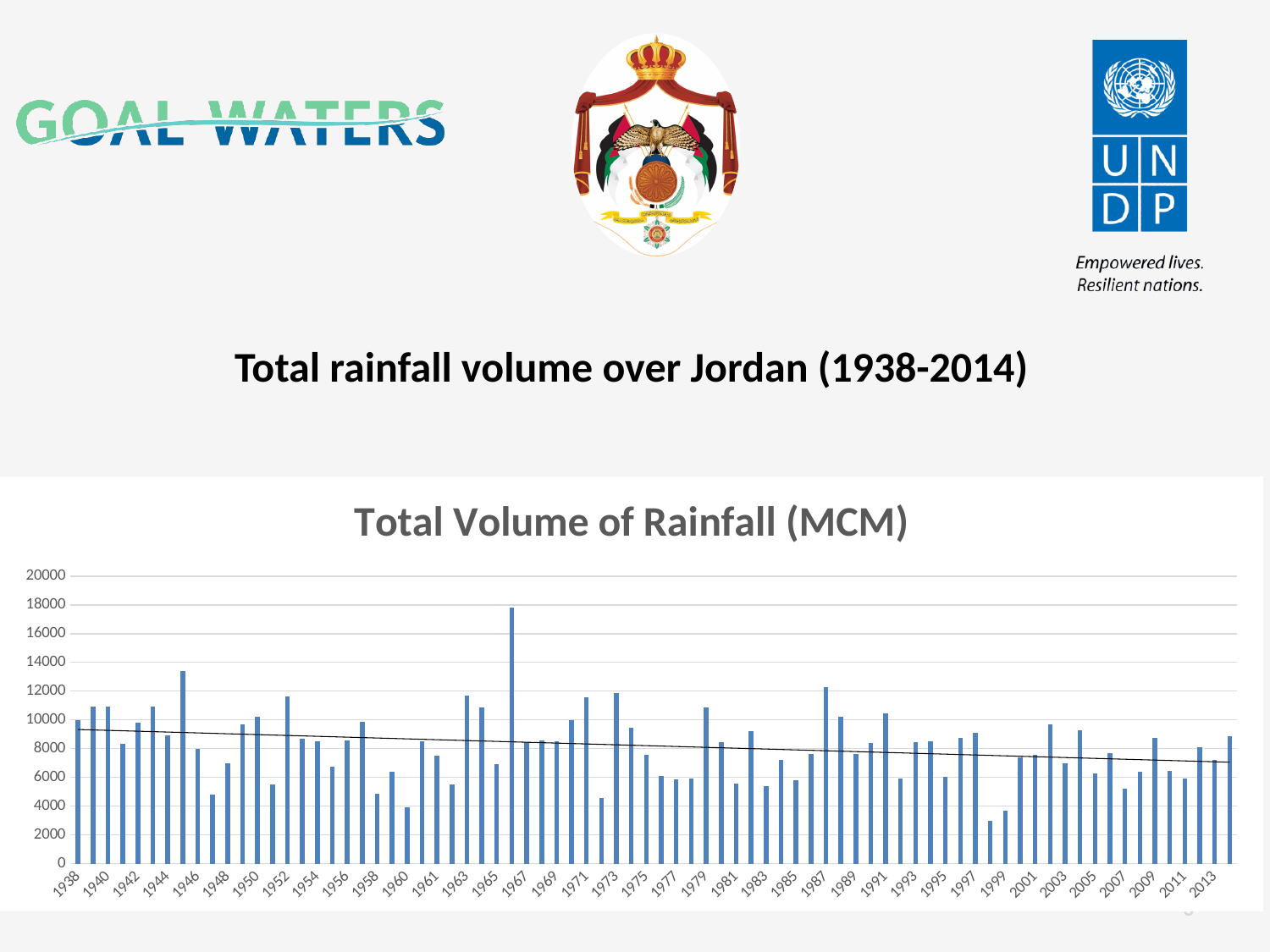
What is the highest value shown on the vertical axis of the chart? 20000 What is the title of the chart? Total Volume of Rainfall (MCM) Is the value for 1973 greater or less than 10000? greater What kind of chart is shown on the slide? bar chart Is the value for 1999 greater or less than 4000? less Is the value for 2007 greater or less than 6000? less According to the trend line, do rainfall volumes generally rise or fall from 1938 to 2014? fall